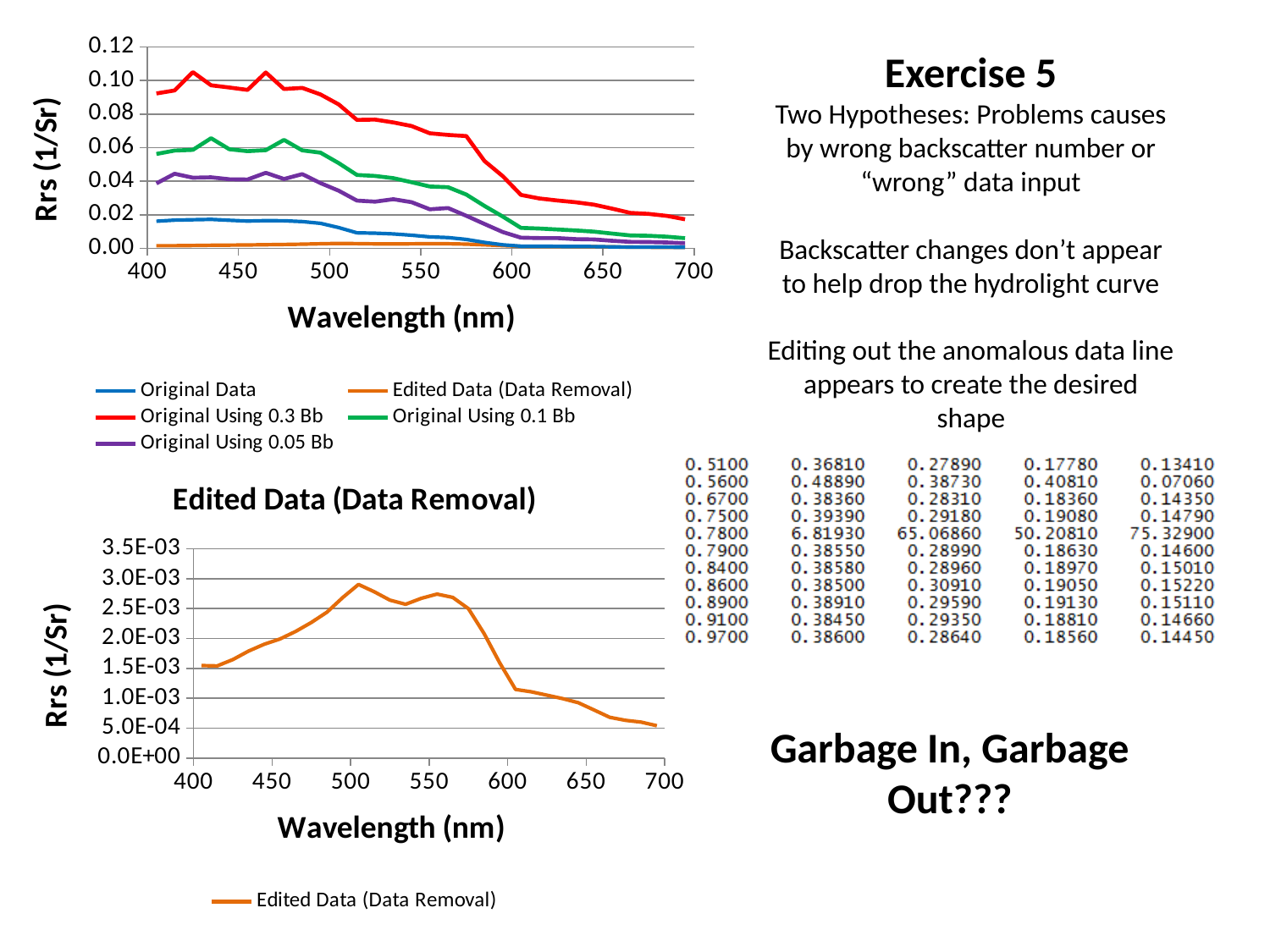
What is the title of the bottom chart? Edited Data (Data Removal) In the top chart, is the value of Original Using 0.3 Bb at 425 nm greater or less than 0.10? greater In the top chart, do the values of Original Using 0.3 Bb generally rise or fall as wavelength increases from 500 nm to 700 nm? fall In the top chart, which series has the lowest values across the wavelength range? Edited Data (Data Removal) In the top chart, which series is larger at 500 nm: Original Using 0.1 Bb or Original Using 0.05 Bb? Original Using 0.1 Bb In the bottom chart 'Edited Data (Data Removal)', is the value at 700 nm greater or less than 1.0E-03? less In the top chart, is the value of Original Using 0.1 Bb at 650 nm greater or less than 0.02? less How many series does the legend of the top chart list? 5 In the top chart, which series has the highest values across the wavelength range? Original Using 0.3 Bb What kind of chart is the top chart on the slide? line chart